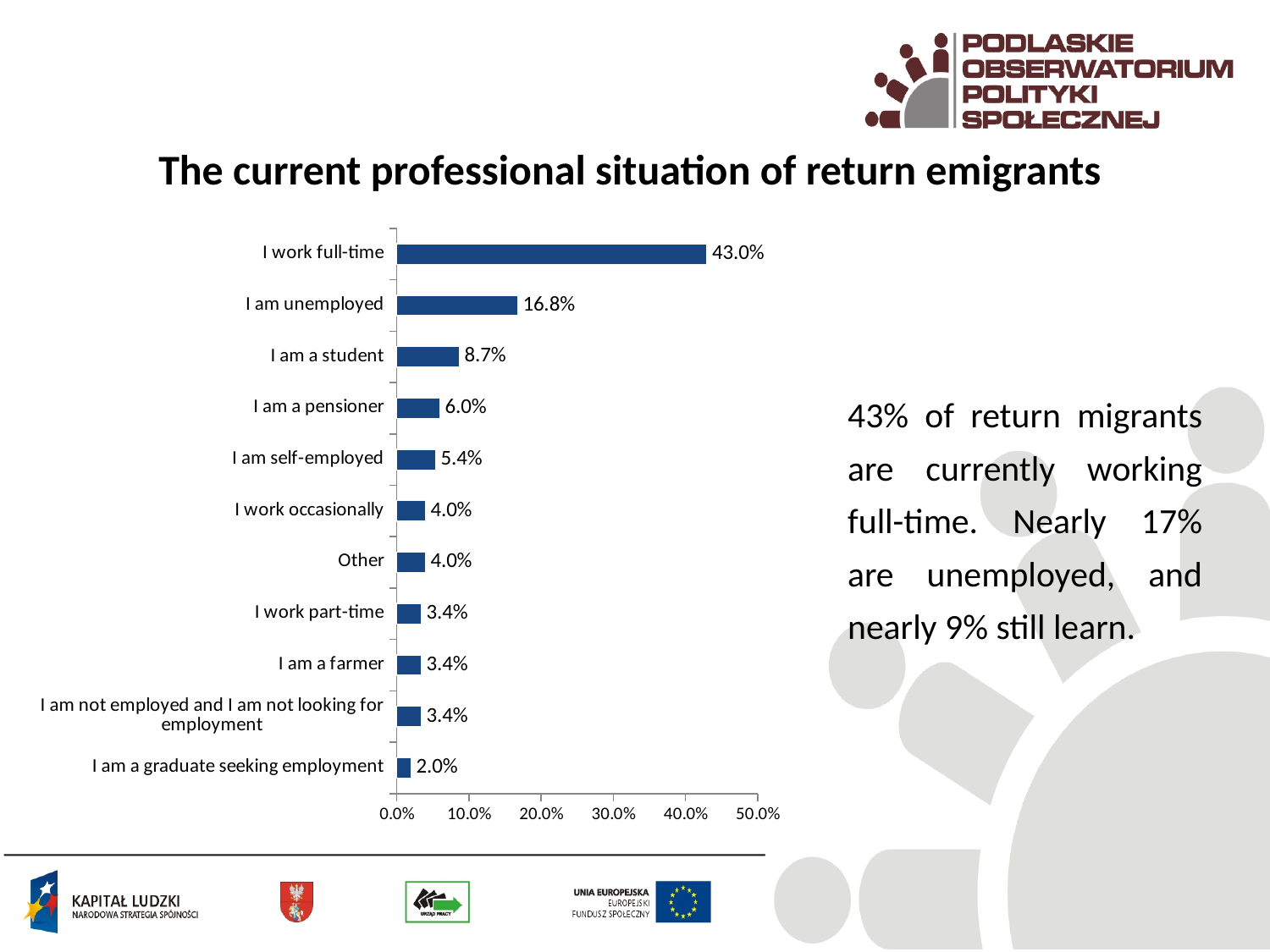
What kind of chart is shown on the slide? Bar chart Which category has the lowest value? I am a graduate seeking employment Is the value for 'I am unemployed' greater or less than 20%? less Which is larger, the value for 'I am a pensioner' or 'I am self-employed'? I am a pensioner How many categories are shown in the chart? 11 What percentage of return emigrants work full-time? 43.0% What is the value for 'I am self-employed'? 5.4% What is the value for 'I am a student'? 8.7% What is the title of the slide? The current professional situation of return emigrants Which category has the highest value? I work full-time What is the difference between 'I work full-time' and 'I am unemployed'? 26.2 percentage points What is the value for 'I am unemployed'? 16.8%